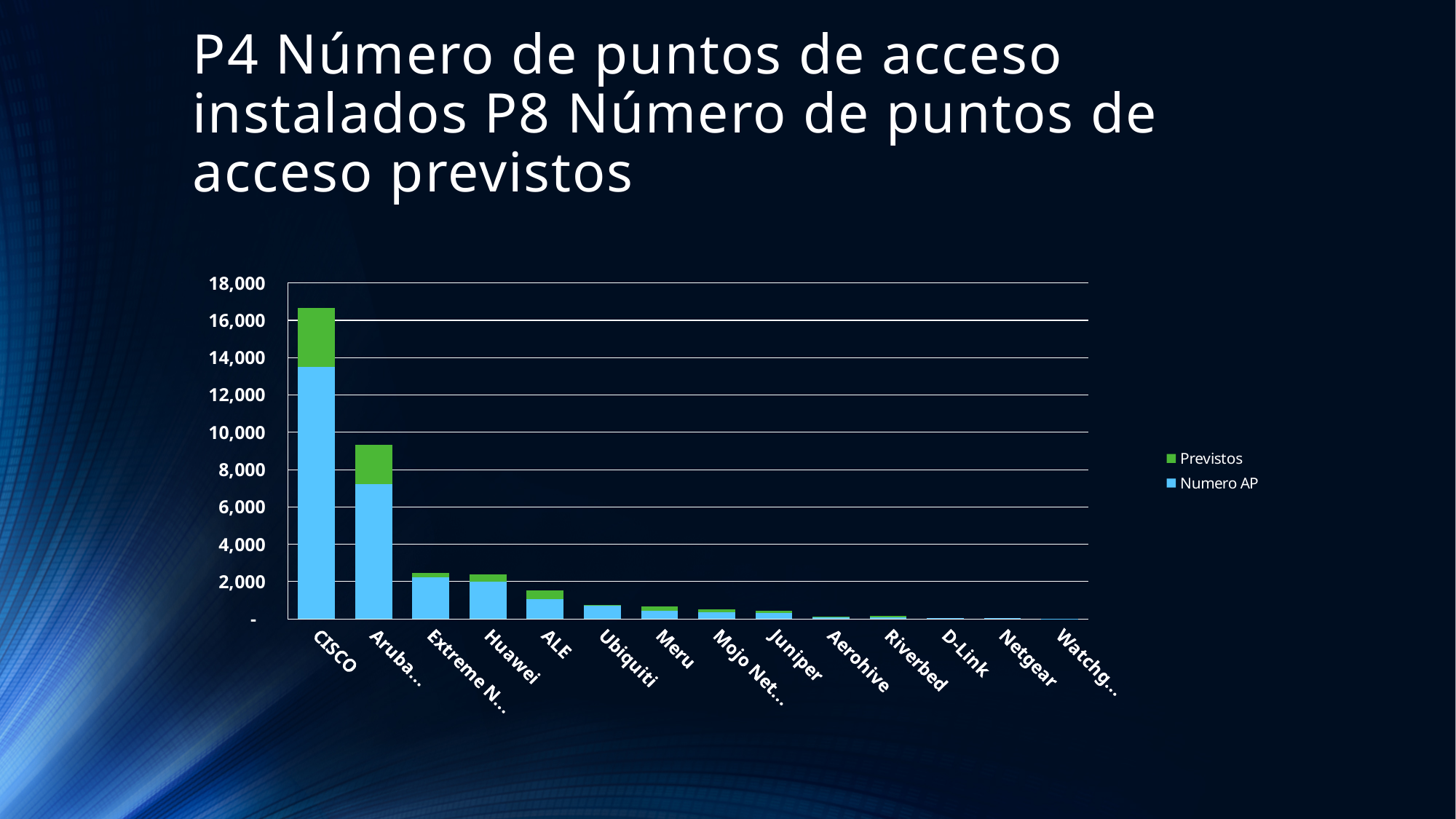
Is the Numero AP value for CISCO greater or less than 12,000? greater Which series is shown in green in the legend? Previstos Which has a larger total bar, Huawei or ALE? Huawei What kind of chart is shown on the slide? Stacked bar chart How many series does the legend list? 2 Do the total bar values rise or fall moving from left to right along the x axis? fall Is the total stacked value for ALE greater or less than 2,000? less Is the total stacked value for Aruba greater or less than 10,000? less Which vendor has the highest total bar? CISCO How many categories (vendors) are shown on the x axis? 14